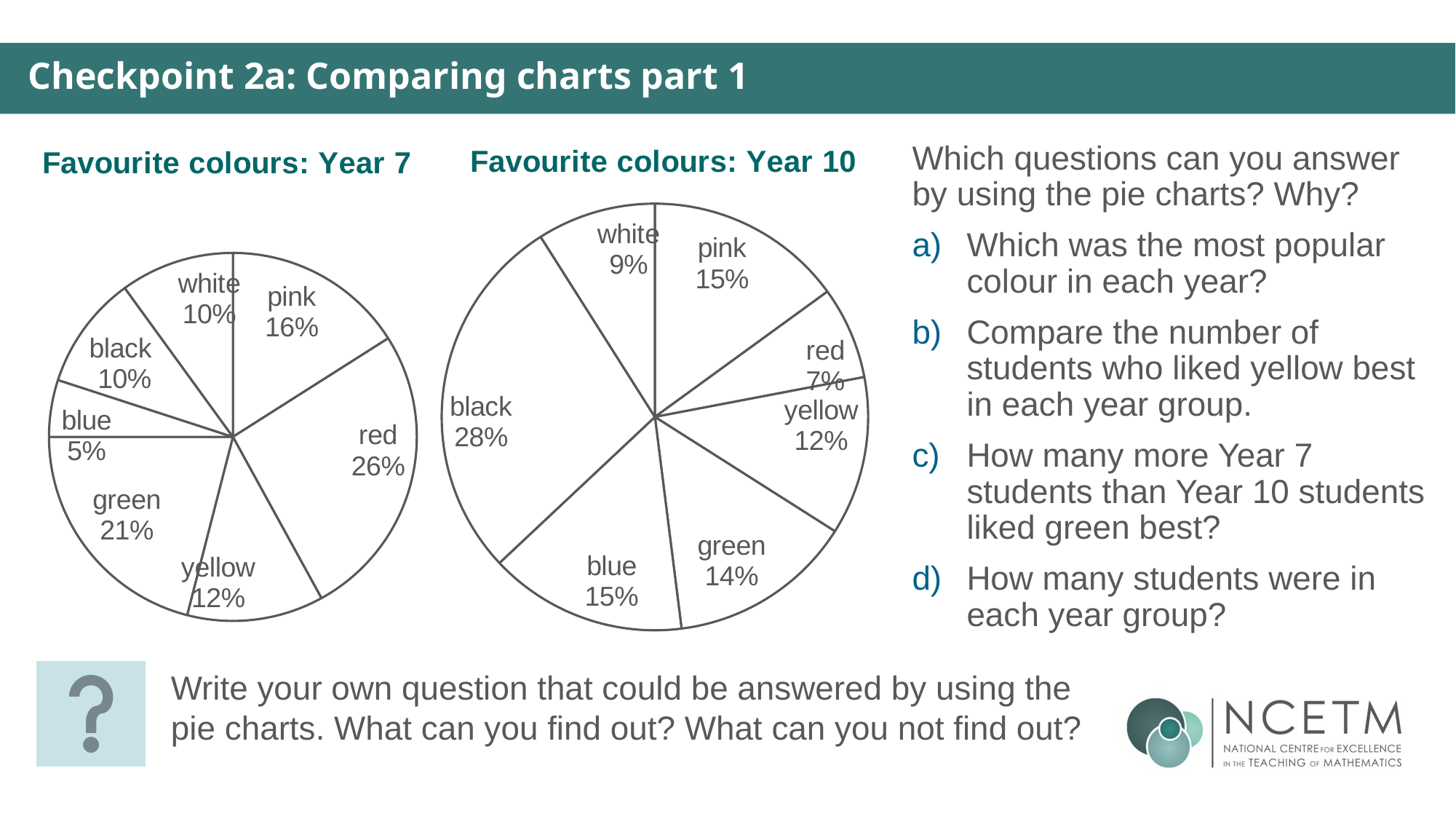
What type of chart is used to show 'Favourite colours: Year 10'? pie chart In the 'Favourite colours: Year 10' pie chart, what percentage of students chose black? 28% In the 'Favourite colours: Year 10' pie chart, what percentage of students chose white? 9% How many slices does the 'Favourite colours: Year 7' pie chart have? 7 In the 'Favourite colours: Year 10' pie chart, which colour has the largest share? black What is the title of the pie chart on the left of the slide? Favourite colours: Year 7 In the 'Favourite colours: Year 7' pie chart, which colour has the largest share? red In the 'Favourite colours: Year 10' pie chart, which colour has the smallest share? red In the 'Favourite colours: Year 7' pie chart, what is the difference in percentage points between green and yellow? 9 In the 'Favourite colours: Year 7' pie chart, what percentage of students chose red? 26% In the 'Favourite colours: Year 10' pie chart, which is larger, the share for pink or the share for green? pink In the 'Favourite colours: Year 7' pie chart, which colour has the smallest share? blue